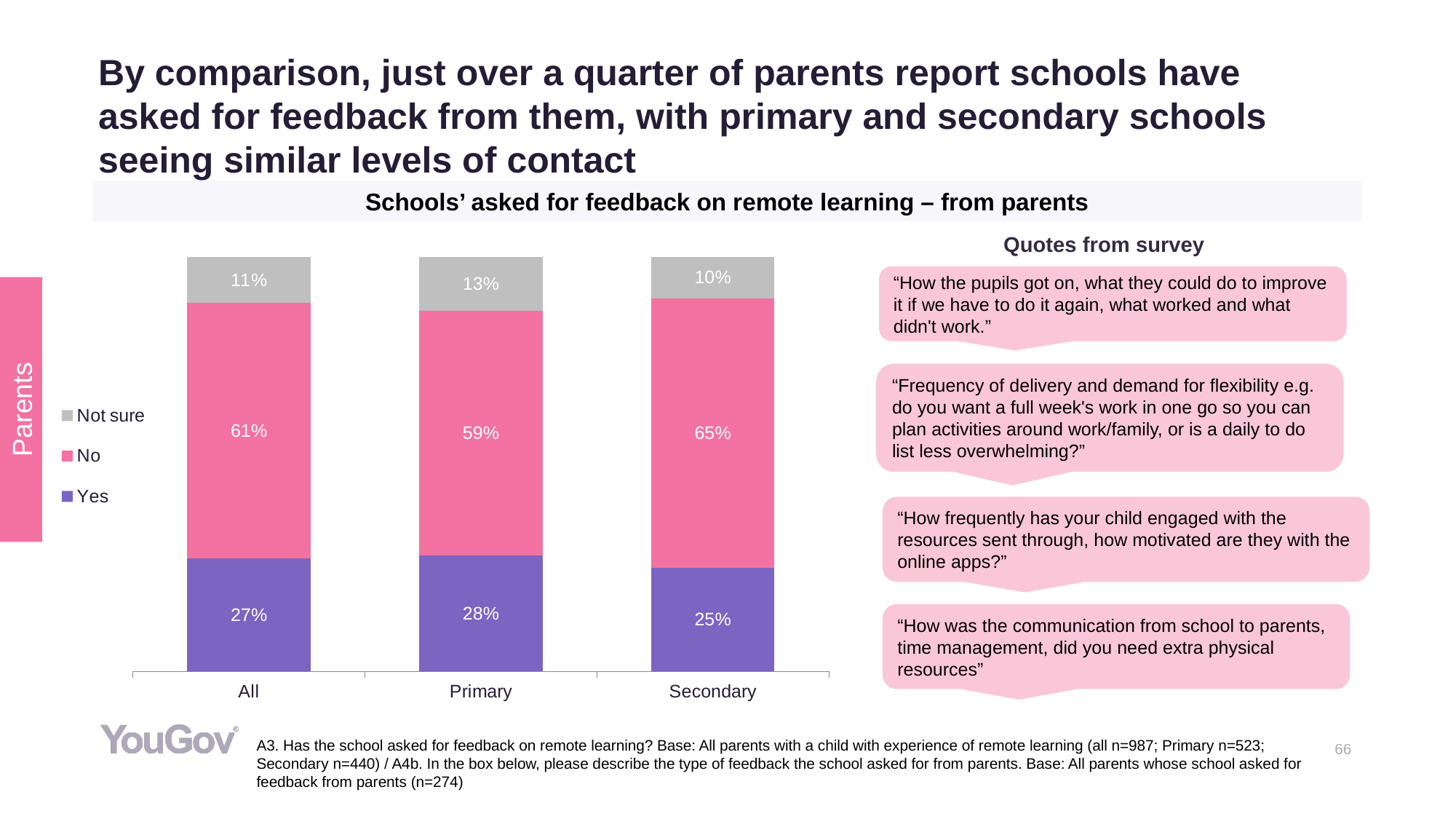
What percentage of All parents answered Yes? 27% What percentage of Primary parents answered Not sure? 13% How many categories are shown on the x axis? 3 What kind of chart is shown? Stacked bar chart What is the total of the stacked bar for Primary? 100% What is the title of the chart? Schools' asked for feedback on remote learning – from parents How many series does the legend list? 3 Which category has the highest Yes value? Primary What is the difference between the No values for Secondary and Primary? 6% Which category has the lowest Not sure value? Secondary Which is larger, the Yes value for All or the Yes value for Secondary? All What percentage of Secondary parents answered No? 65%